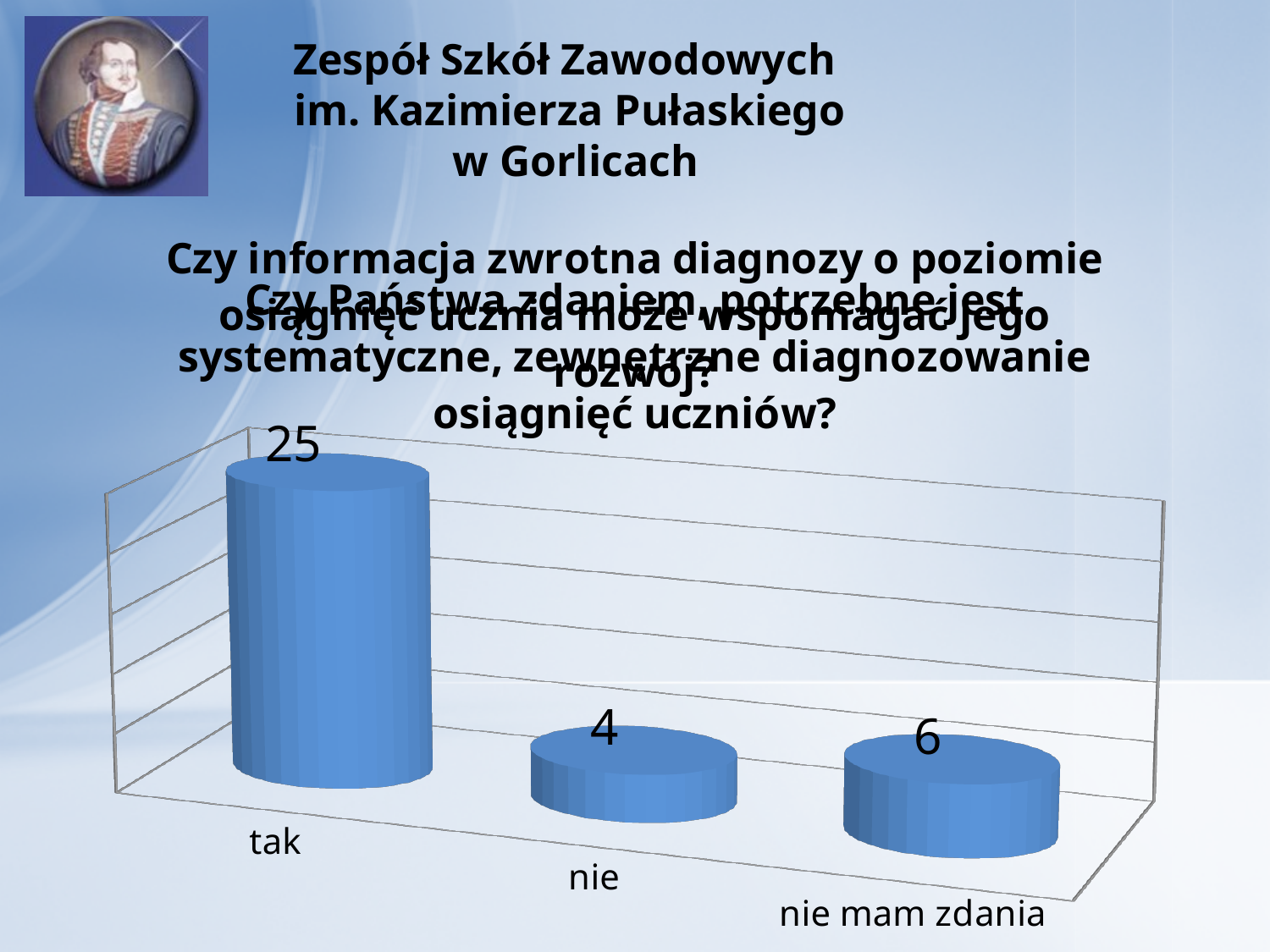
Which category has the highest value? tak Which is larger, the value for "nie" or the value for "nie mam zdania"? nie mam zdania What is the difference between the values for "nie mam zdania" and "nie"? 2 What is the value for "nie mam zdania"? 6 What is the value for "tak"? 25 How many categories are shown in the chart? 3 What colour are the bars in the chart? blue Which category has the lowest value? nie What is the value for "nie"? 4 What is the difference between the values for "tak" and "nie"? 21 What is the total of the three values shown in the chart? 35 What kind of chart is shown on the slide? bar chart